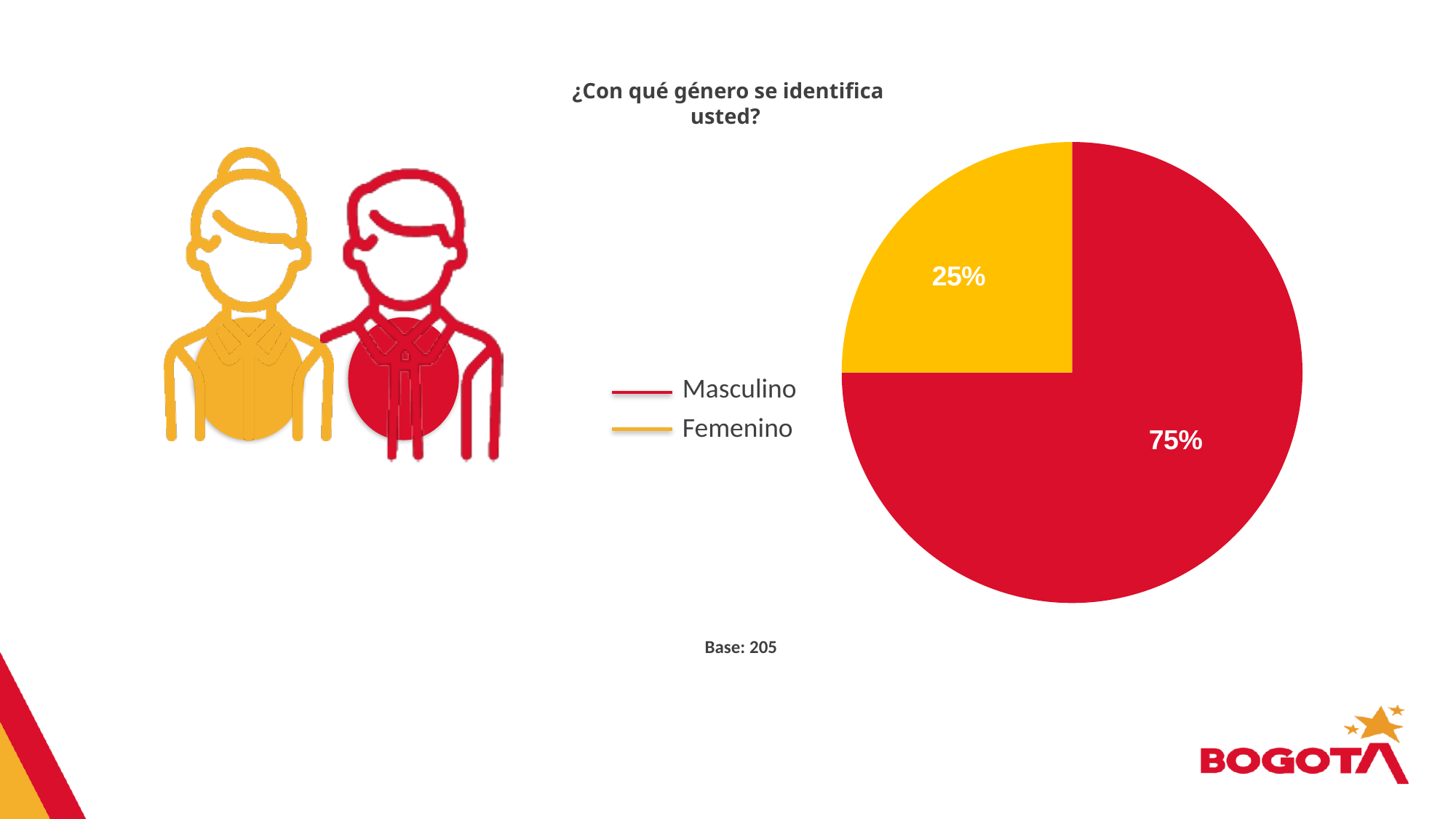
What share of the pie does the Femenino slice represent? 25% What is the difference in percentage points between Masculino and Femenino? 50 How many entries does the legend list? 2 How many categories are shown in the pie chart? 2 What percentage of respondents identified as Masculino? 75% What colour is the Masculino slice in the pie chart? Red Which is larger, the share for Masculino or the share for Femenino? Masculino What percentage of respondents identified as Femenino? 25% What is the title of the chart? ¿Con qué género se identifica usted? What kind of chart is shown on the slide? Pie chart Which gender category has the largest share of the pie? Masculino Which gender category has the smallest share of the pie? Femenino